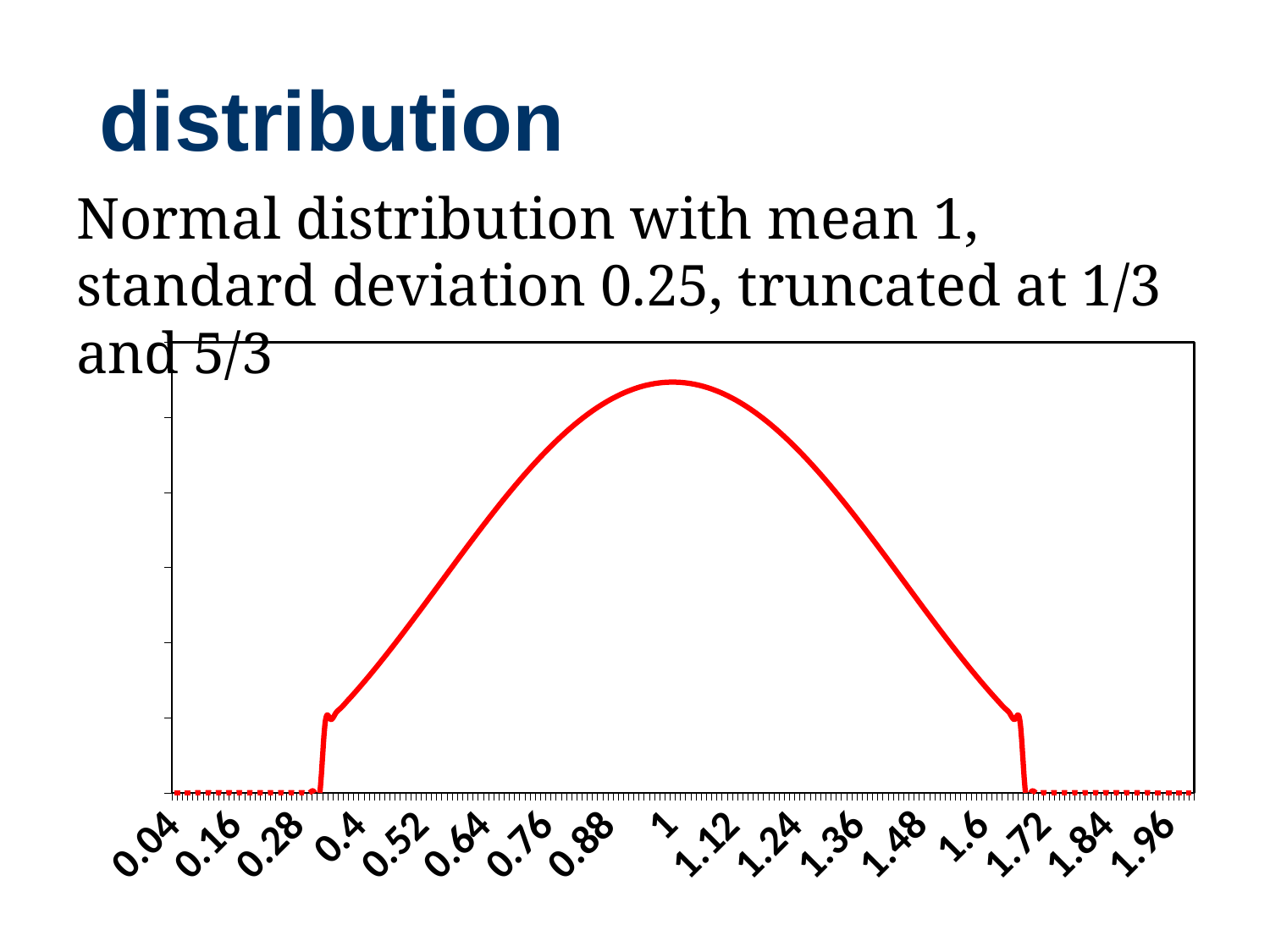
How many labels are printed along the x axis? 17 Is the plotted value at x = 0.64 larger or smaller than the value at x = 1? smaller Is the plotted value at x = 1.24 larger or smaller than the value at x = 1.84? larger Does the curve rise or fall as x increases from 1 to 1.6? fall What is the last label printed on the x axis? 1.96 Does the curve rise or fall as x increases from 0.4 to 1? rise Is the plotted value at x = 0.16 larger or smaller than the value at x = 0.52? smaller At which x-axis label does the plotted curve reach its highest value? 1 What kind of chart is shown on the slide? line chart What is the first label printed on the x axis? 0.04